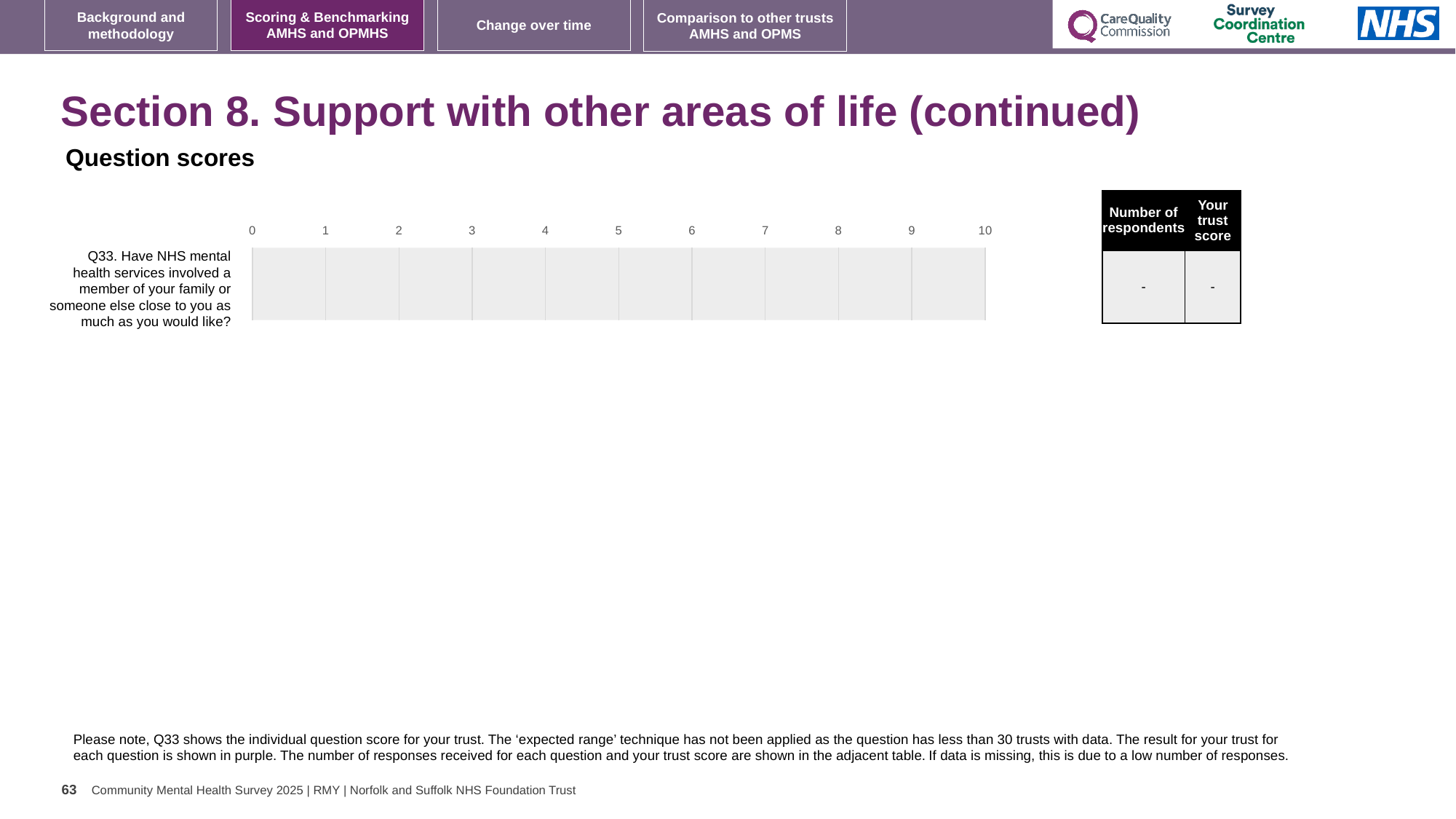
How many questions (categories) are listed on the chart? 1 Is a bar plotted for Q33 on the chart? No What kind of chart is shown on the slide? bar chart What is the highest value shown on the chart's horizontal axis? 10 What is shown in the 'Number of respondents' column for Q33? - What is the lowest value shown on the chart's horizontal axis? 0 Which question number is shown on the chart? Q33 What is shown in the 'Your trust score' column for Q33? -